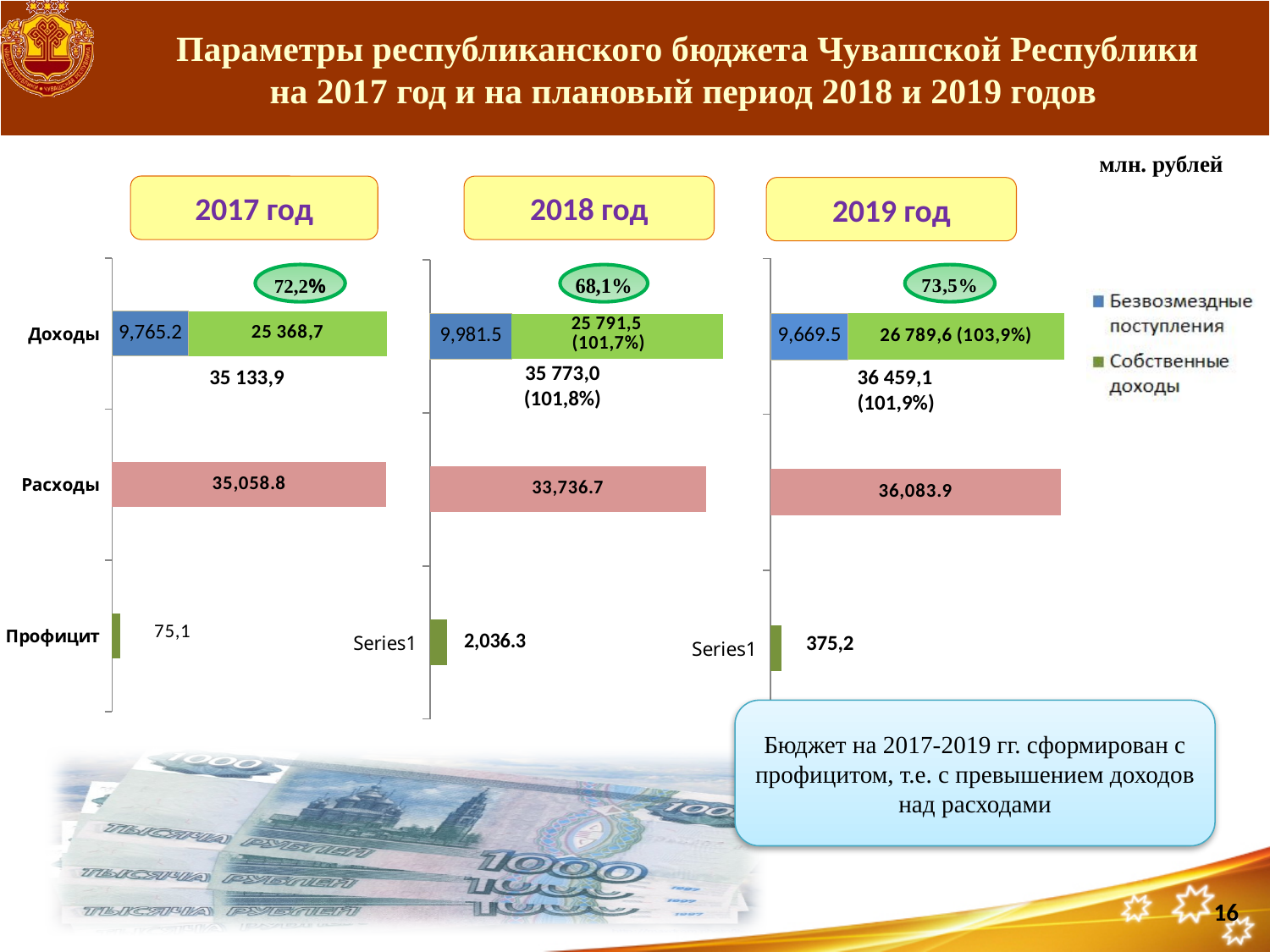
In the 2019 год chart, what is the value for Расходы? 36,083.9 In the 2017 год chart, what is the total of the stacked Доходы bar? 35 133,9 In the 2019 год chart, what is the value for Профицит? 375,2 What kind of chart is the 2017 год chart? Bar chart How many categories are shown on the vertical axis of the 2017 год chart? 3 How many series does the legend on the right of the slide list? 2 In the 2017 год chart, what is the value of Собственные доходы for Доходы? 25 368,7 In the 2018 год chart, what is the value for Профицит? 2,036.3 In the 2017 год chart, what is the value of Безвозмездные поступления for Доходы? 9,765.2 In the 2018 год chart, what is the value for Расходы? 33,736.7 In the 2018 год chart, which is larger: the Расходы bar or the Профицит bar? Расходы In the 2019 год chart, what is the value of Безвозмездные поступления for Доходы? 9,669.5